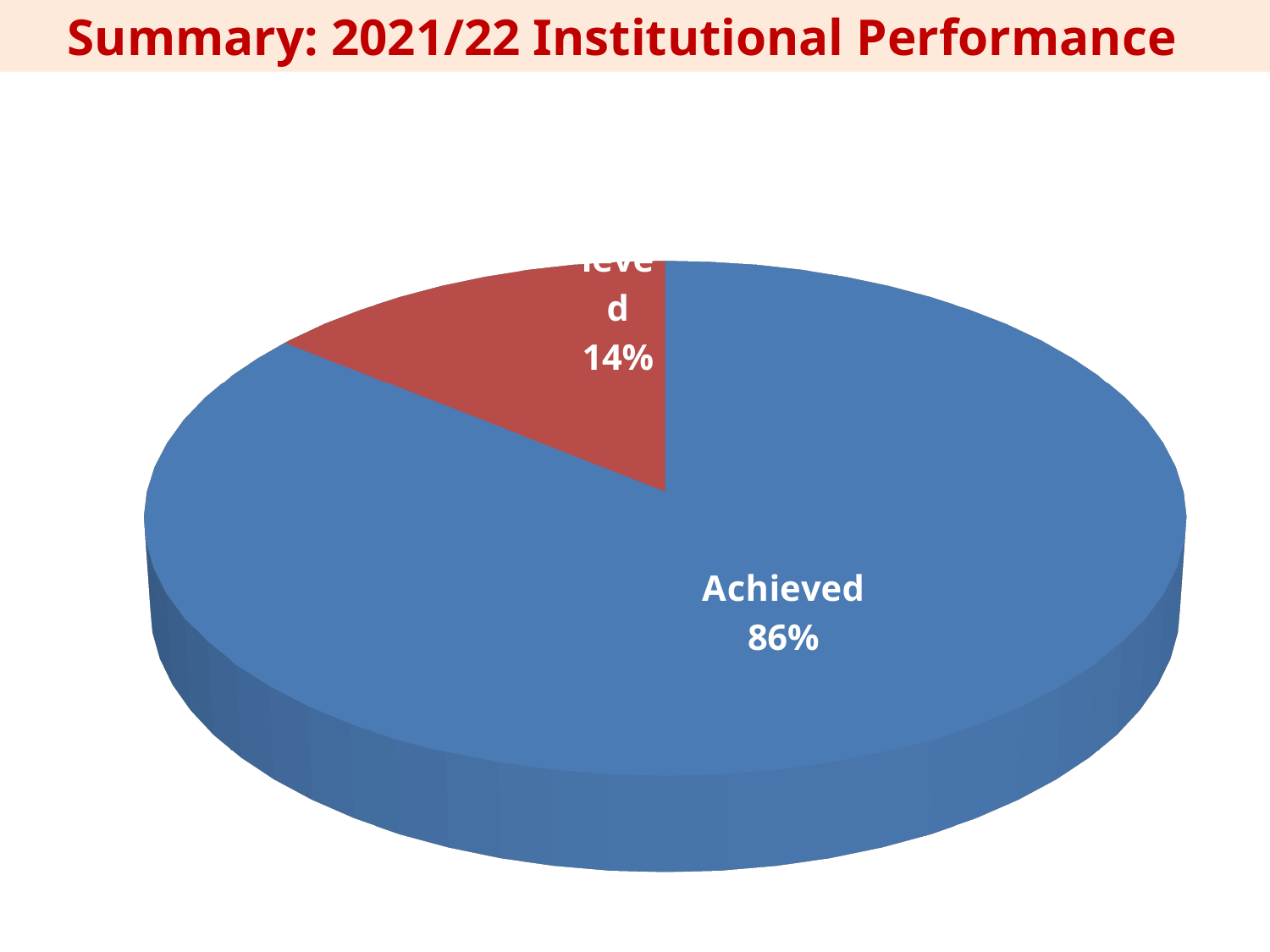
What share of the pie does the Achieved slice represent? 86% How many slices does the pie chart have? 2 What is the title of the slide containing the pie chart? Summary: 2021/22 Institutional Performance What colour is the Achieved slice of the pie chart? Blue Do the two slices of the pie chart add up to 100%? Yes What is the difference in percentage points between the Achieved slice and the red slice? 72 Which slice of the pie chart is the largest? Achieved Which is larger: the Achieved slice or the red slice? Achieved What percentage is shown on the red slice of the pie chart? 14% What kind of chart is shown on the slide? Pie chart